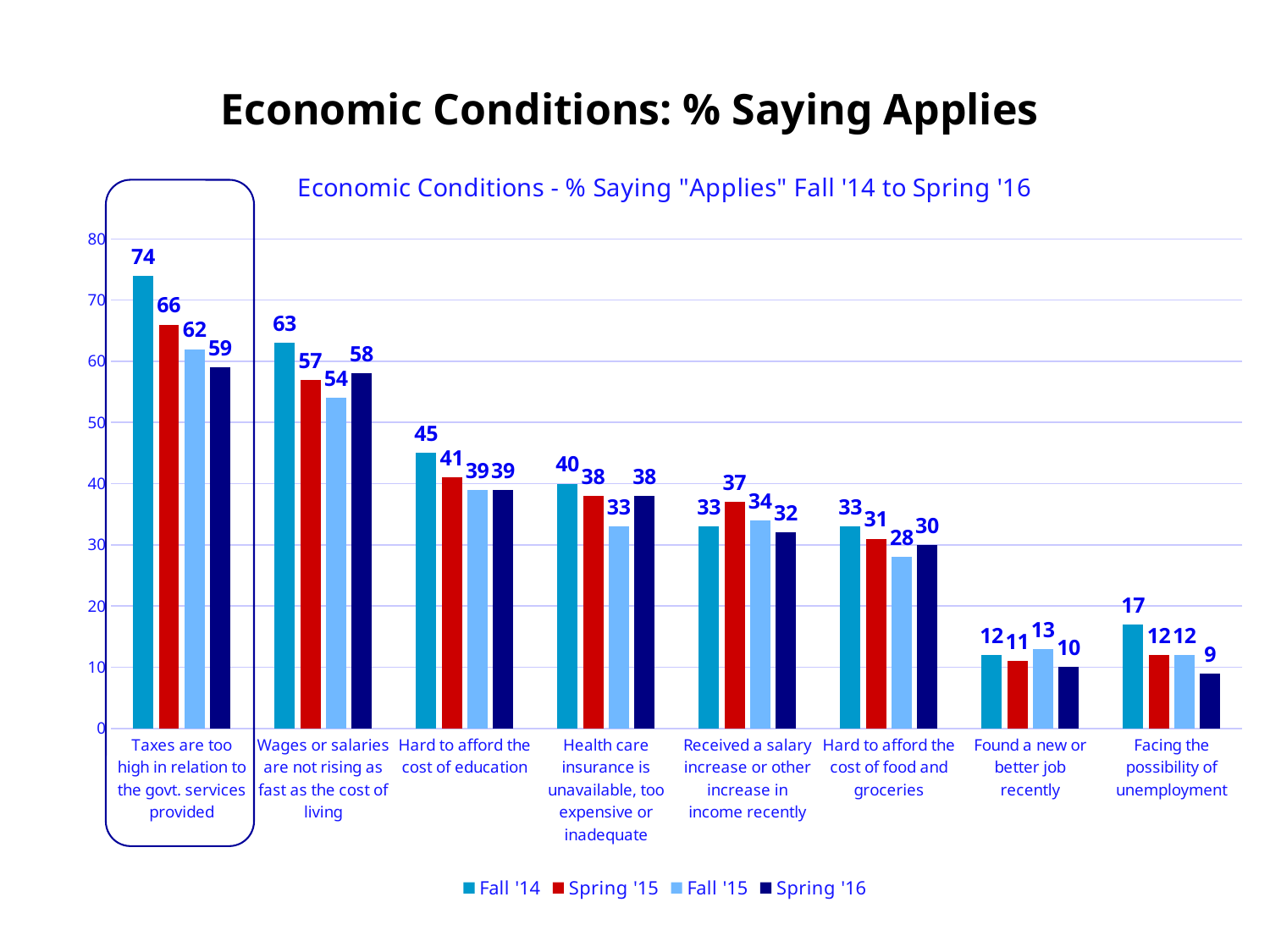
What is the Fall '15 value for "Health care insurance is unavailable, too expensive or inadequate"? 33 Which category has the highest Fall '14 value? Taxes are too high in relation to the govt. services provided What is the difference between the Fall '14 and Spring '16 values for "Taxes are too high in relation to the govt. services provided"? 15 How many series does the legend list? 4 What kind of chart is shown on the slide? Bar chart What is the title of the chart? Economic Conditions - % Saying "Applies" Fall '14 to Spring '16 Do the Fall '14 values rise or fall moving from left to right along the x axis? Fall Which is larger for "Received a salary increase or other increase in income recently": the Spring '15 value or the Spring '16 value? Spring '15 What is the Spring '16 value for "Wages or salaries are not rising as fast as the cost of living"? 58 Which category has the lowest Spring '16 value? Facing the possibility of unemployment What is the Fall '14 value for "Taxes are too high in relation to the govt. services provided"? 74 How many categories are shown on the x axis? 8